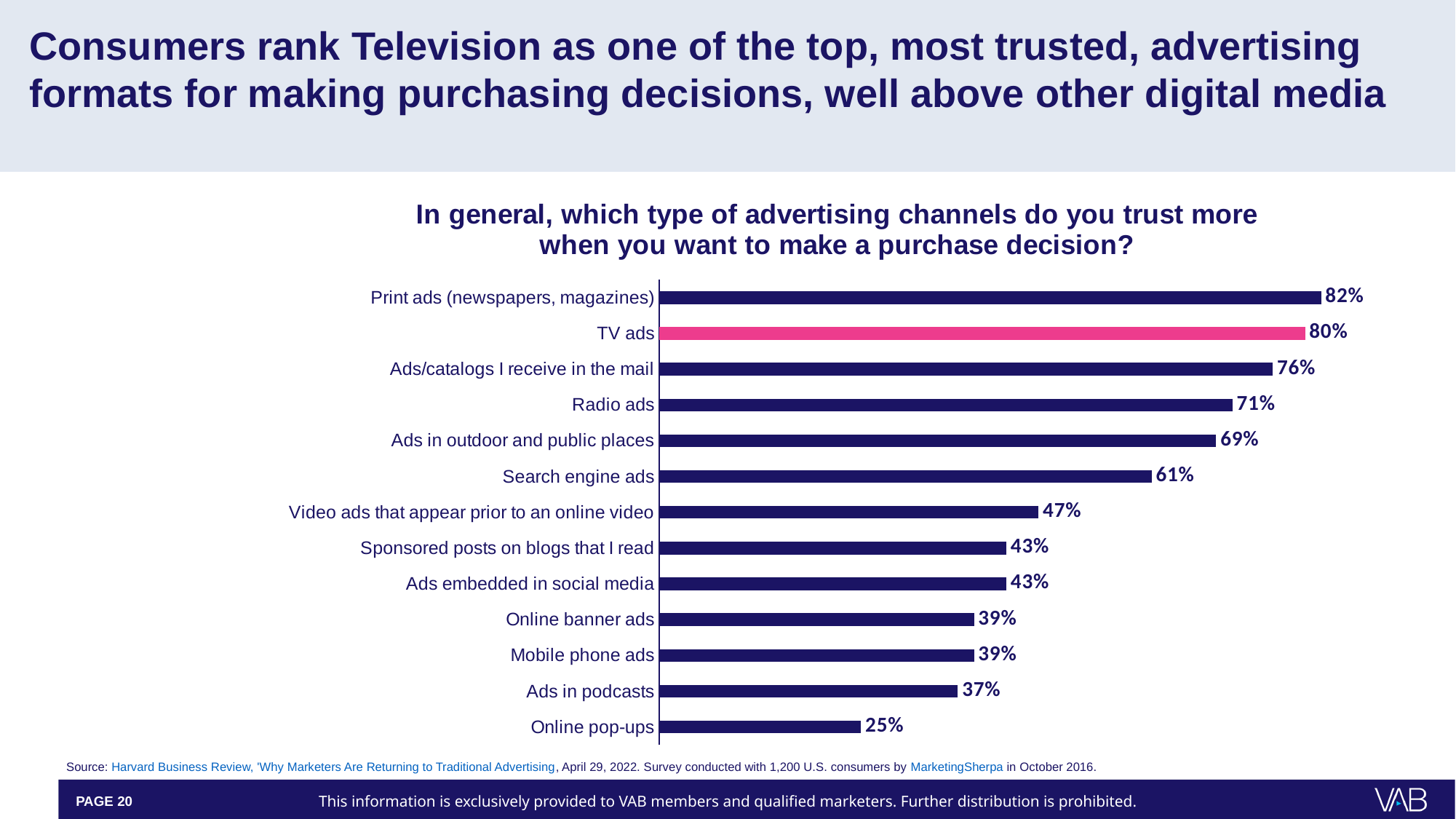
What is the value shown for Radio ads? 71% How many advertising channels are shown in the chart? 13 Which has a higher value, Ads/catalogs I receive in the mail or Ads in outdoor and public places? Ads/catalogs I receive in the mail What is the difference between the values for TV ads and Search engine ads? 19% Which bar is highlighted in a different colour (pink) from the others? TV ads Which advertising channel has the lowest trust percentage? Online pop-ups What type of chart is shown on the slide? Bar chart What is the value shown for Ads in podcasts? 37% Which advertising channel has the highest trust percentage? Print ads (newspapers, magazines) What percentage of consumers trust TV ads when making a purchase decision? 80% Which has a higher value, Video ads that appear prior to an online video or Online banner ads? Video ads that appear prior to an online video What is the difference between the values for Print ads (newspapers, magazines) and TV ads? 2%